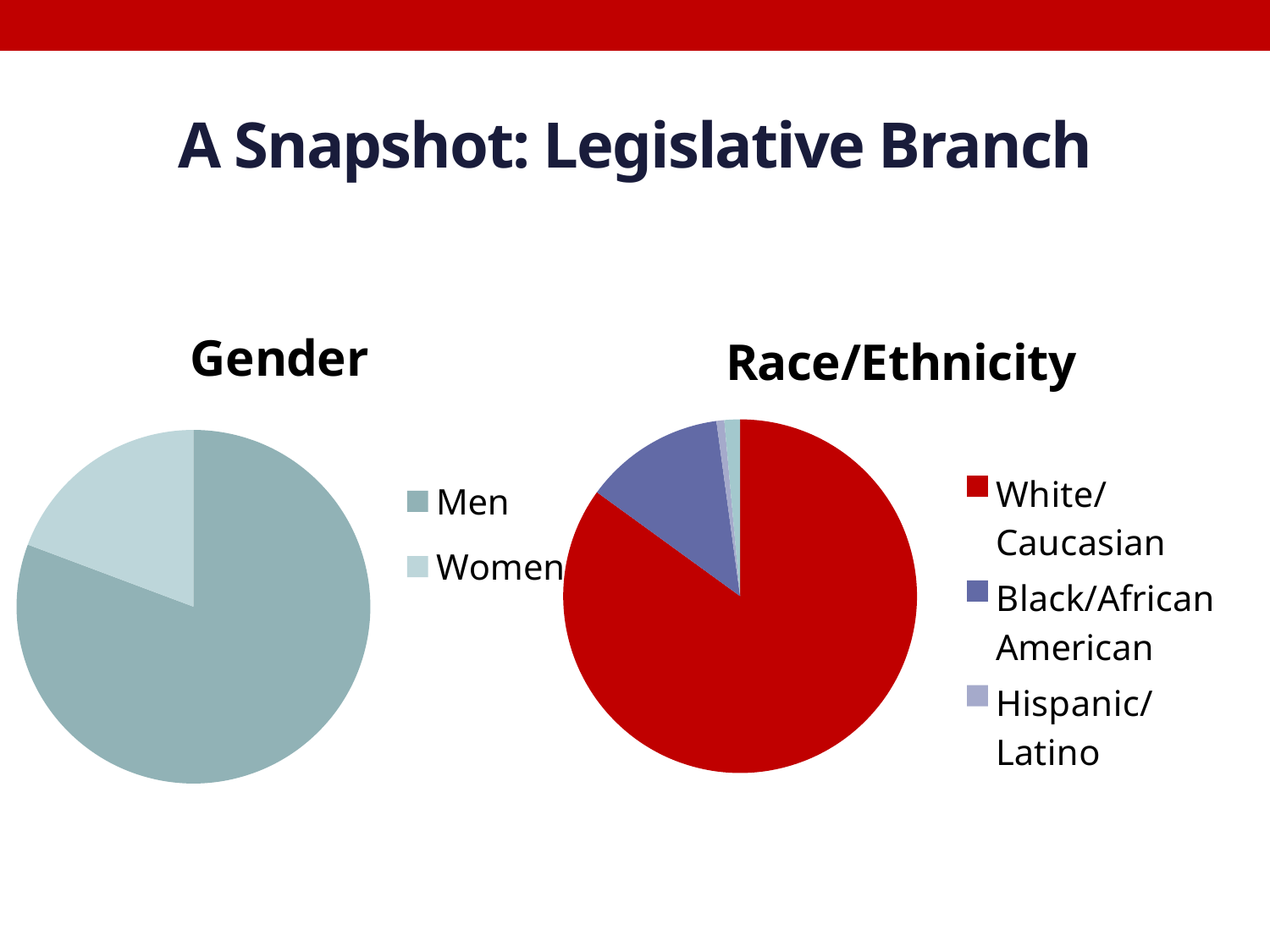
In the Race/Ethnicity chart, what colour is the White/Caucasian slice? red What kind of chart is the Race/Ethnicity chart? pie chart In the Gender chart, which category has the smallest slice? Women In the Race/Ethnicity chart, which legend category has the smallest slice? Hispanic/Latino What kind of chart is the Gender chart? pie chart In the Race/Ethnicity chart, which slice is larger: Black/African American or Hispanic/Latino? Black/African American In the Race/Ethnicity chart, how many categories does the legend list? 3 In the Gender chart, which category has the largest slice? Men In the Gender chart, how many categories does the legend list? 2 What is the title of the chart on the left of the slide? Gender In the Gender chart, which slice is larger: Men or Women? Men In the Race/Ethnicity chart, which category has the largest slice? White/Caucasian